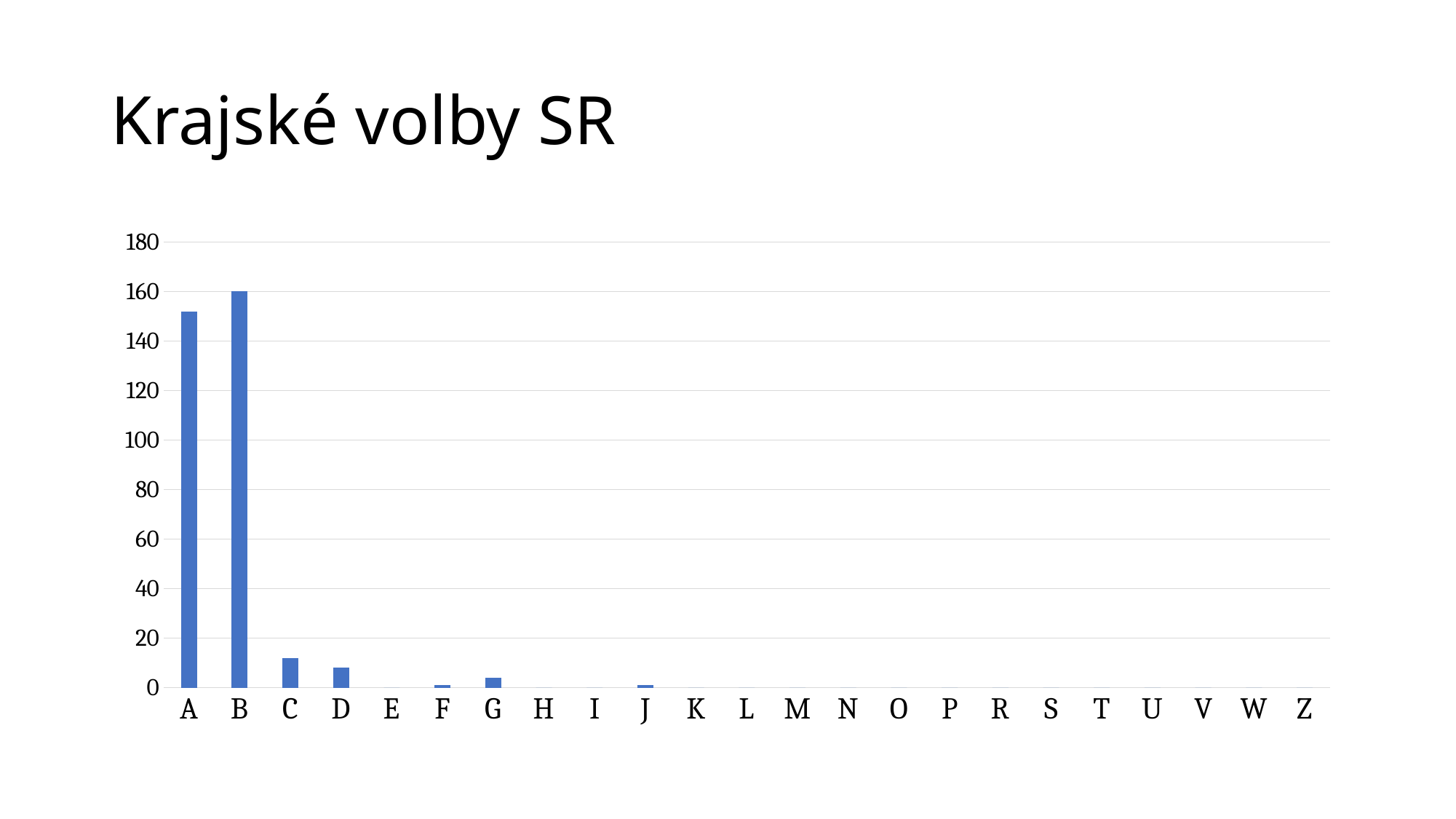
Is the value for C greater or less than 20? less Which category has the highest value? B Is the value for A greater or less than 160? less Which is larger, the value for A or the value for B? B What is the value for category B? 160 What is the title of the chart? Krajské volby SR Which is larger, the value for C or the value for D? C What kind of chart is shown on the slide? bar chart Is the value for A greater or less than 140? greater How many categories are shown on the x axis? 23